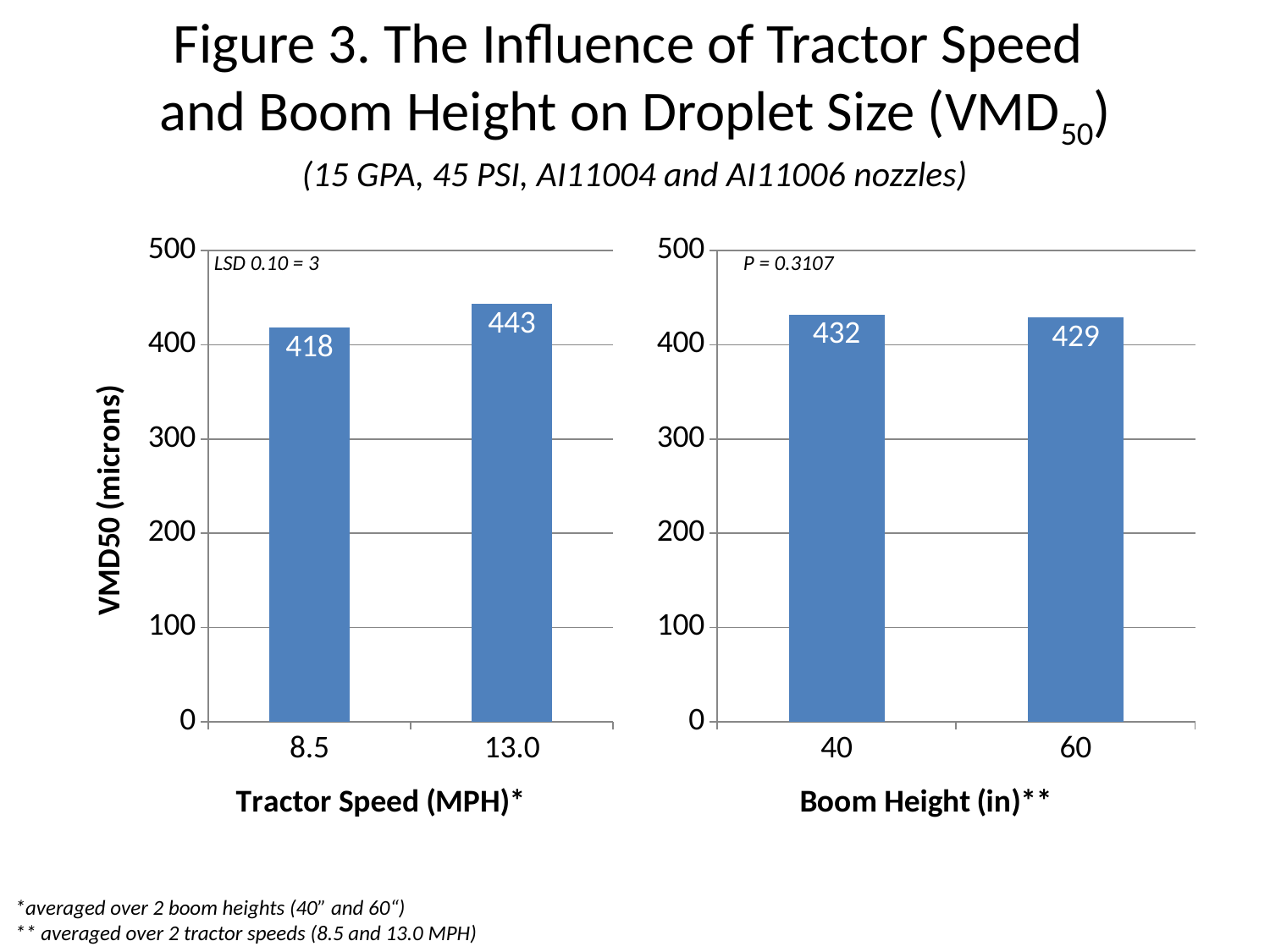
In the left chart (Tractor Speed), what is the difference in VMD50 between 13.0 MPH and 8.5 MPH? 25 In the right chart (Boom Height), what is the VMD50 value for 60 in? 429 In the left chart (Tractor Speed), is the value for 8.5 MPH greater or less than 400? greater What kind of chart is the left chart (Tractor Speed)? bar chart In the left chart (Tractor Speed), which tractor speed has the higher VMD50? 13.0 In the right chart (Boom Height), what is the difference in VMD50 between 40 in and 60 in? 3 What is the y-axis label of the left chart (Tractor Speed)? VMD50 (microns) In the right chart (Boom Height), what is the VMD50 value for 40 in? 432 In the left chart (Tractor Speed), what is the VMD50 value for 13.0 MPH? 443 In the left chart (Tractor Speed), what is the VMD50 value for 8.5 MPH? 418 In the left chart (Tractor Speed), does VMD50 rise or fall as tractor speed increases from 8.5 to 13.0 MPH? rise In the right chart (Boom Height), how many boom height categories are shown? 2